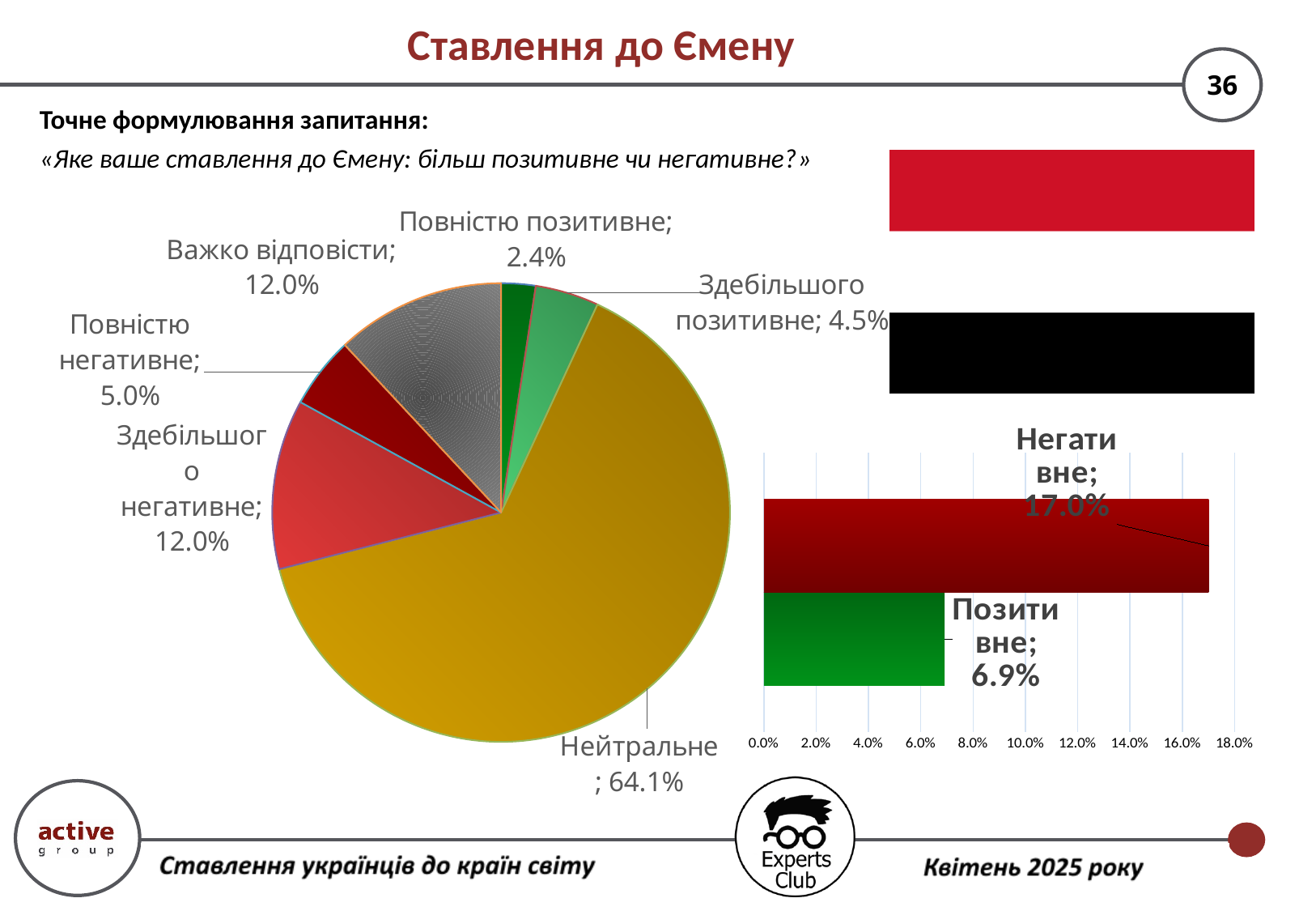
On the bar chart at the bottom right, what is the value for "Негативне"? 17.0% On the pie chart, which category has the largest slice? Нейтральне On the pie chart, what share is labelled for "Повністю негативне"? 5.0% On the pie chart, what is the difference between the shares for "Здебільшого негативне" and "Повністю негативне"? 7.0% On the pie chart, what share is labelled for "Повністю позитивне"? 2.4% On the pie chart, what share is labelled for "Здебільшого позитивне"? 4.5% What type of chart is shown at the bottom right of the slide? Bar chart On the bar chart at the bottom right, what is the value for "Позитивне"? 6.9% On the pie chart, which category has the smallest slice? Повністю позитивне On the pie chart, how many slices (categories) are there? 6 On the bar chart at the bottom right, what is the difference between "Негативне" and "Позитивне"? 10.1% On the pie chart, what share is labelled for "Нейтральне"? 64.1%